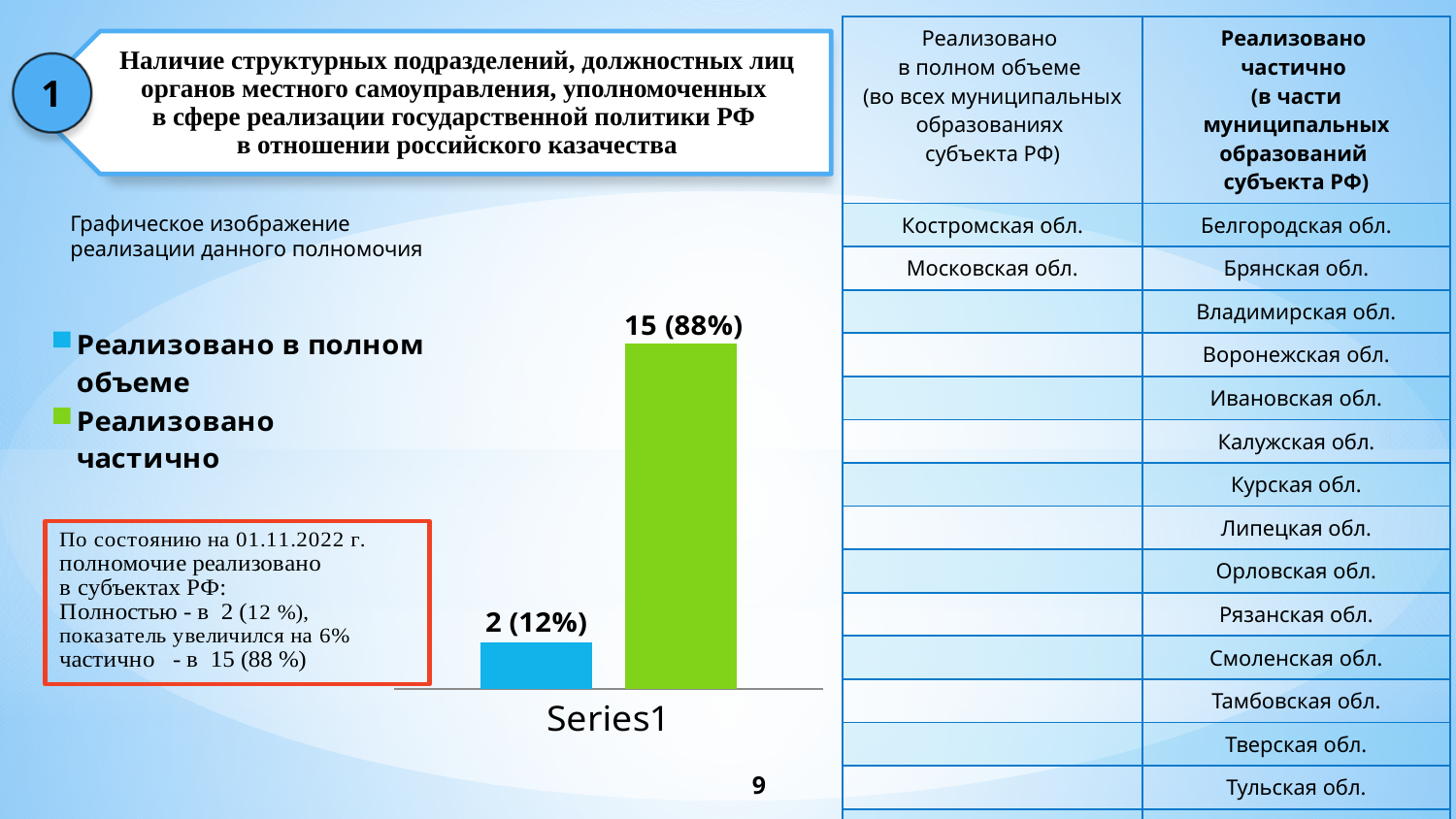
Which series has the lower bar in the chart? Реализовано в полном объеме What is the total of the two bar values in the chart? 17 What is the difference in count between "Реализовано частично" and "Реализовано в полном объеме"? 13 How many series does the chart legend list? 2 What type of chart is shown on the slide? bar chart What value is shown for the series "Реализовано частично" in the chart? 15 (88%) What colour is the bar for "Реализовано частично"? green Is the bar for "Реализовано в полном объеме" larger or smaller than the bar for "Реализовано частично"? smaller How many bars are plotted in the chart? 2 What value is shown for the series "Реализовано в полном объеме" in the chart? 2 (12%) What label appears on the category axis below the bars? Series1 Which series has the higher bar in the chart? Реализовано частично